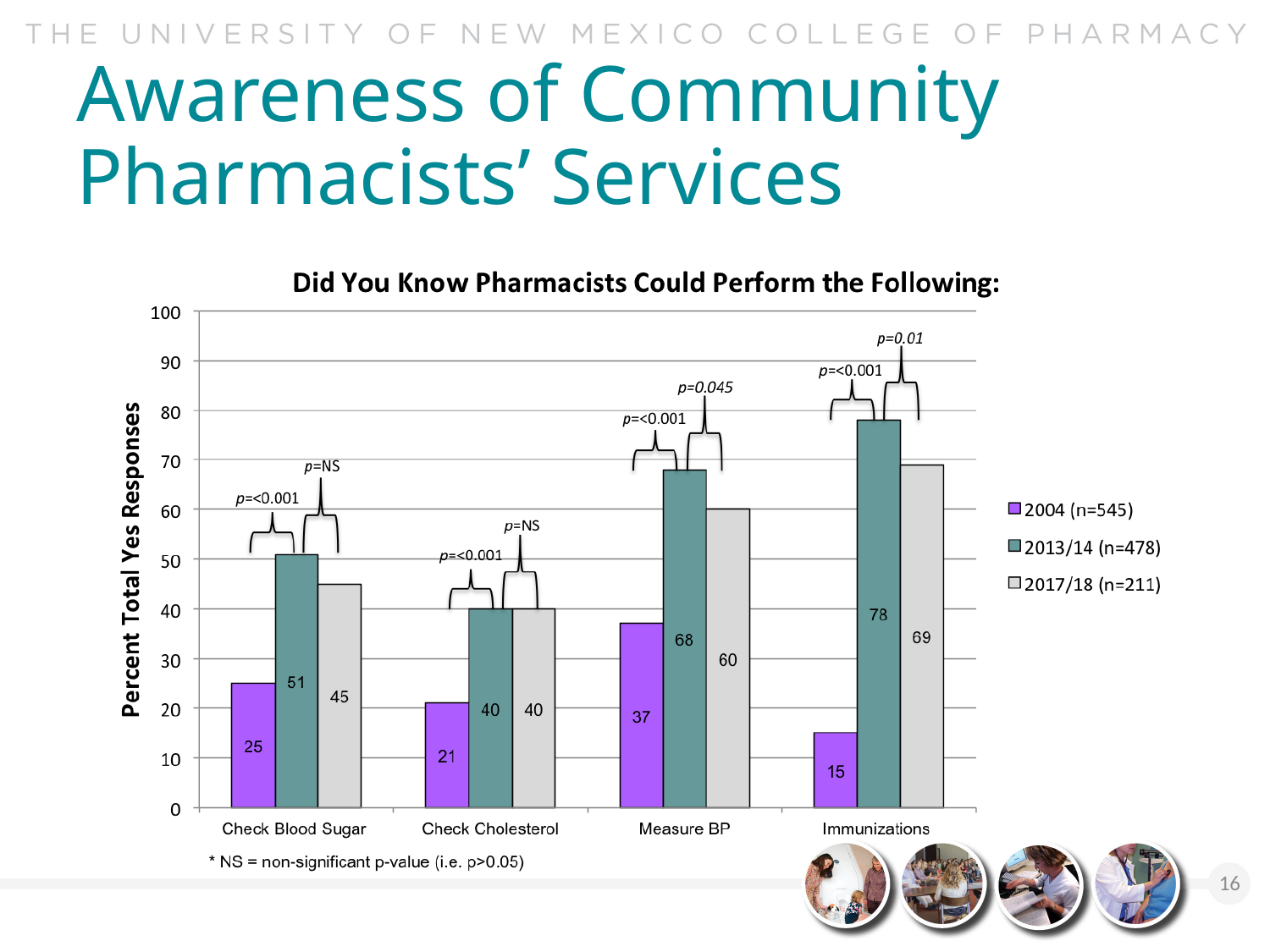
What is the difference between the 2013/14 (n=478) and 2017/18 (n=211) values for Check Blood Sugar? 6 What is the value for 2004 (n=545) for Check Cholesterol? 21 Which is larger: the 2017/18 (n=211) value for Measure BP or the 2017/18 (n=211) value for Check Blood Sugar? Measure BP What is the value for 2017/18 (n=211) for Measure BP? 60 How many categories are shown on the x axis? 4 Which category has the highest value for the 2013/14 (n=478) series? Immunizations How many series does the legend list? 3 Is the 2004 (n=545) value for Measure BP greater or less than 40? less What is the difference between the 2013/14 (n=478) and 2004 (n=545) values for Immunizations? 63 What type of chart is shown on the slide? bar chart What is the value for 2013/14 (n=478) for Immunizations? 78 Which category has the lowest value for the 2004 (n=545) series? Immunizations